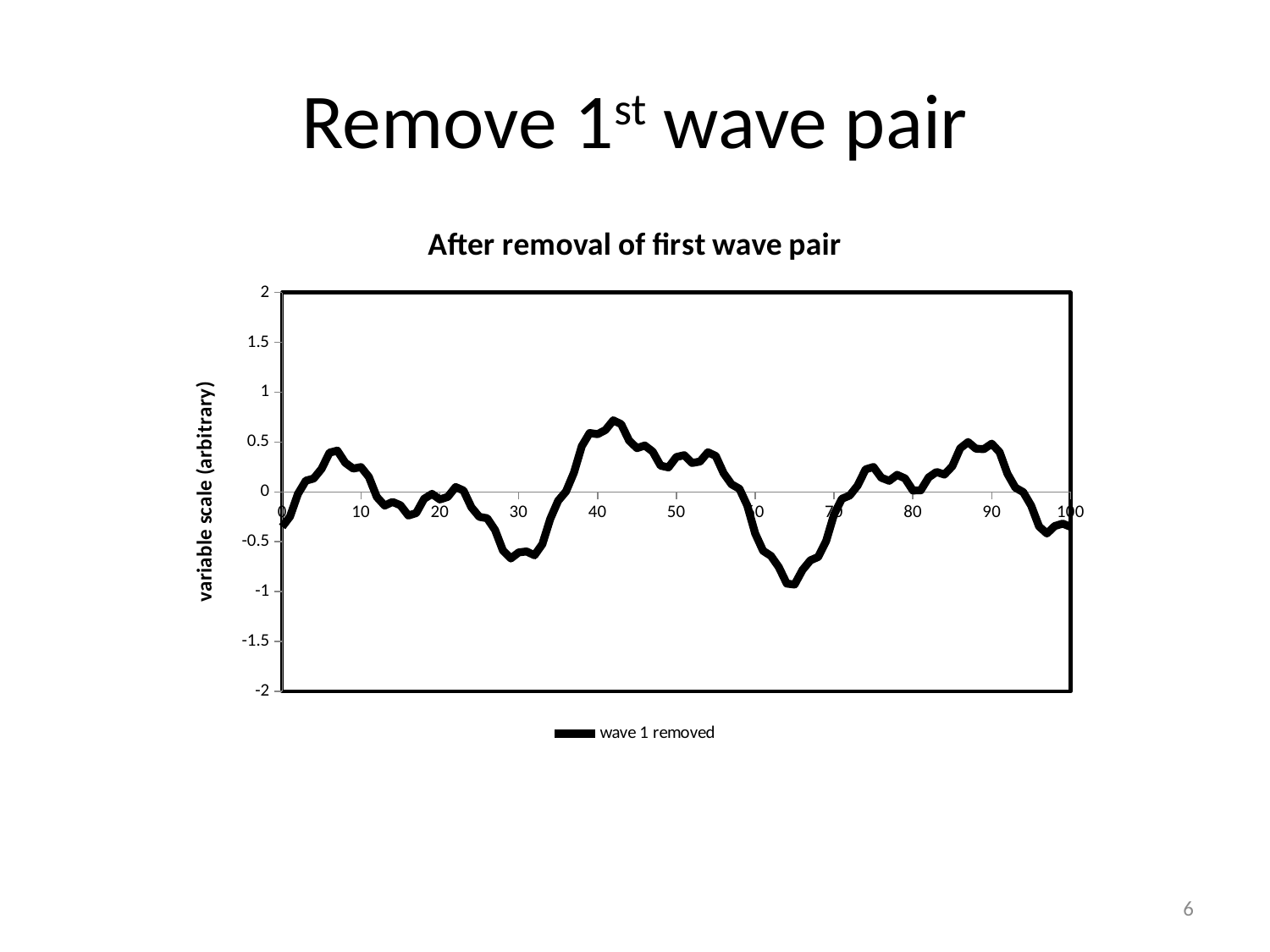
Is the value of the line at x = 65 greater or less than -0.5? less Is the value of the line at x = 87 greater or less than 0? greater How many series does the legend list? 1 Is the value of the line at x = 0 greater or less than 0? less Which is larger, the value of the line at x = 42 or at x = 65? x = 42 What kind of chart is shown on the slide? line chart Does the line rise or fall between x = 55 and x = 65? fall What is the label of the y axis? variable scale (arbitrary) Does the line rise or fall between x = 30 and x = 42? rise What is the title of the chart? After removal of first wave pair